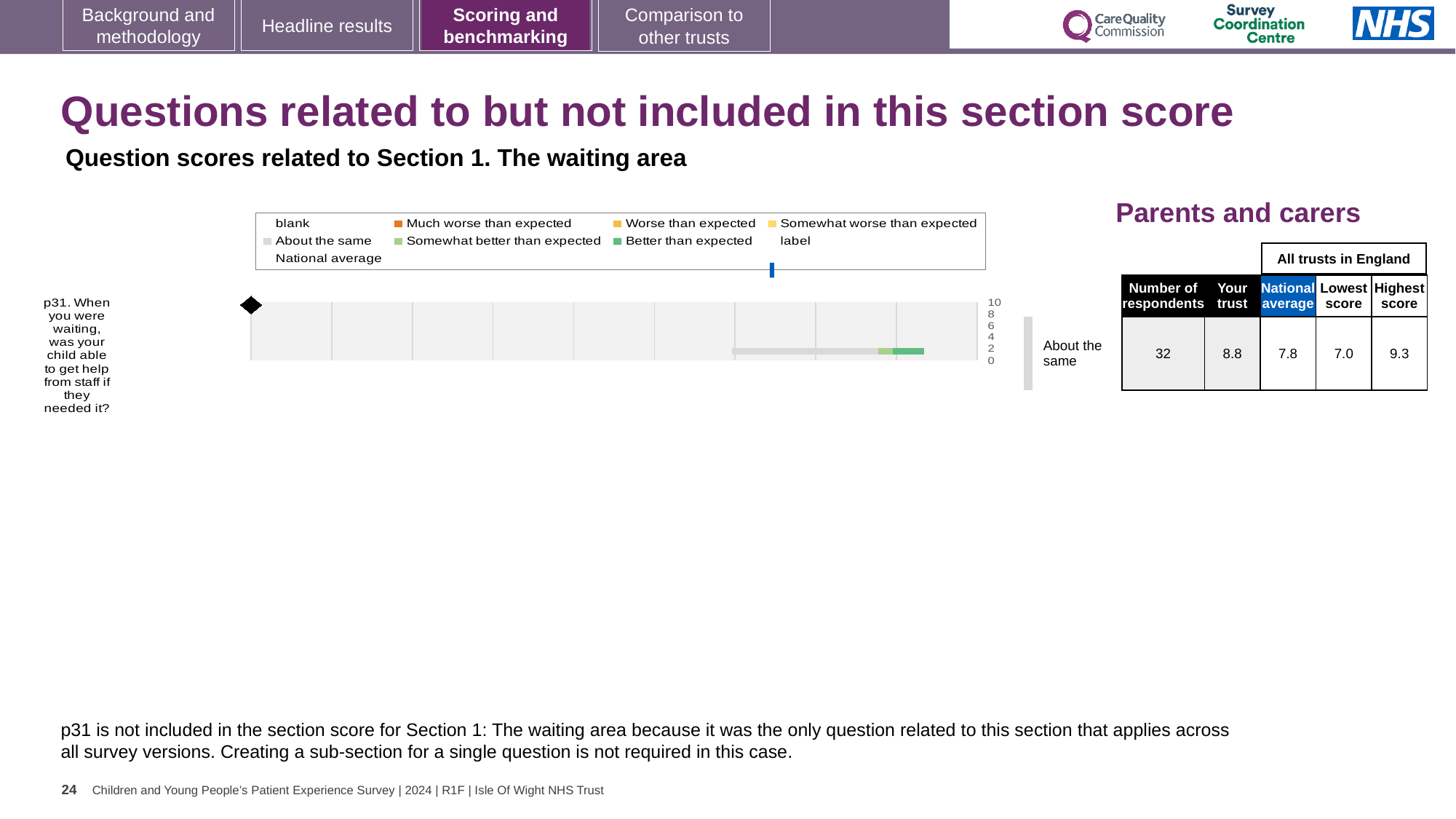
What is the difference between the 'Your trust' score and the National average for p31? 1.0 What is the National average score for p31 in the Parents and carers table? 7.8 What is the 'Your trust' score for p31 in the Parents and carers table? 8.8 What kind of chart is shown for question p31 on the slide? bar chart What is the Highest score across all trusts in England for p31? 9.3 How many entries does the chart legend list? 9 Which is larger for p31: the 'Your trust' score or the National average? Your trust How many respondents answered p31 according to the table? 32 What benchmark category is shown next to the bar for p31? About the same What is the Lowest score across all trusts in England for p31? 7.0 How many questions (categories) are plotted in the chart? 1 Which question is plotted in the chart? p31. When you were waiting, was your child able to get help from staff if they needed it?